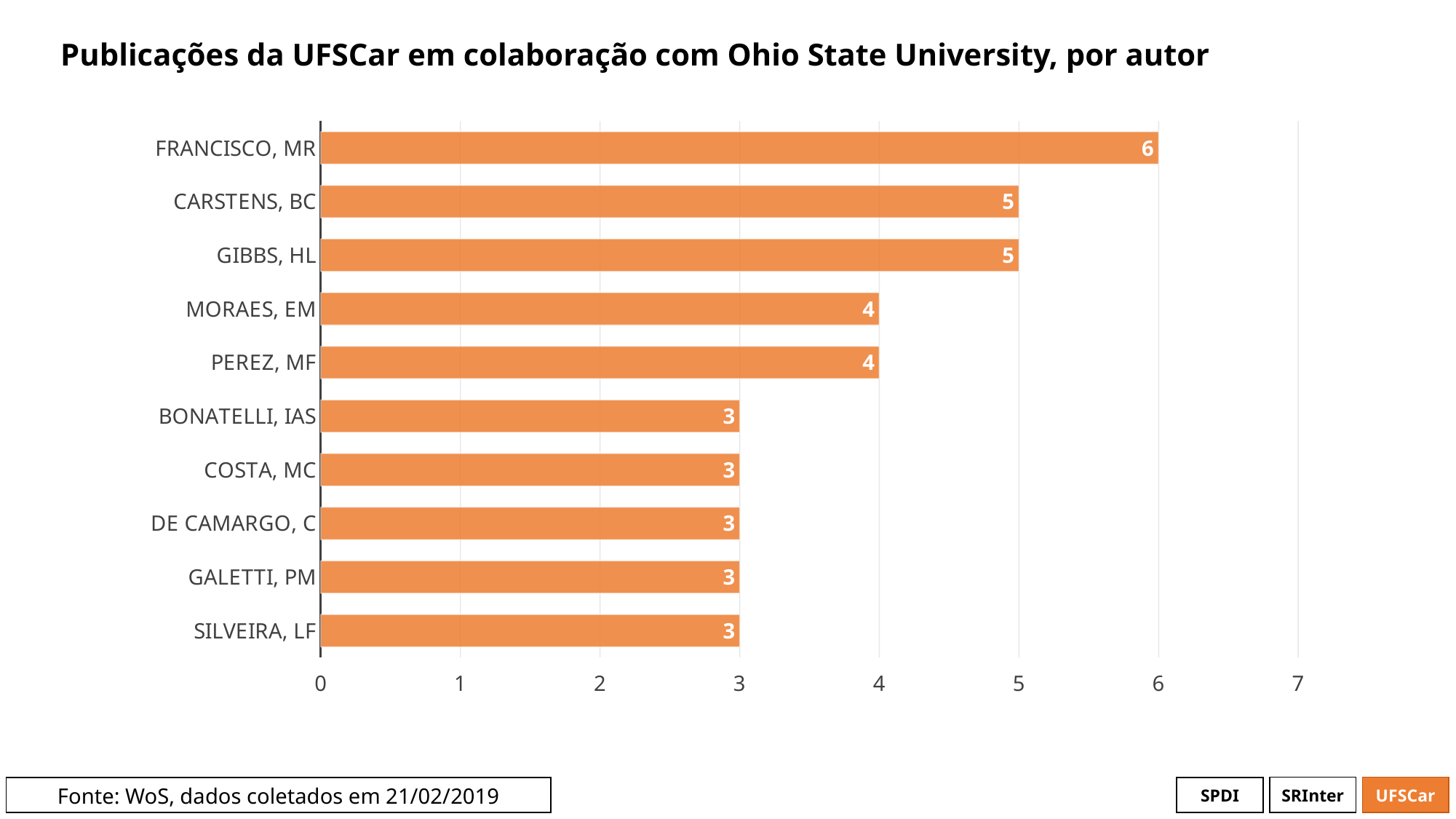
Which author has the highest number of publications? FRANCISCO, MR What is the difference between the values for PEREZ, MF and SILVEIRA, LF? 1 How many authors are shown in the chart? 10 What is the value for GIBBS, HL? 5 How many publications does FRANCISCO, MR have? 6 Is the value for FRANCISCO, MR greater or less than 5? greater Which is larger, the value for CARSTENS, BC or the value for BONATELLI, IAS? CARSTENS, BC What is the title of the chart? Publicações da UFSCar em colaboração com Ohio State University, por autor What is the difference between the values for FRANCISCO, MR and CARSTENS, BC? 1 What is the value for MORAES, EM? 4 How many authors have a value of 3? 5 What kind of chart is shown on the slide? Bar chart